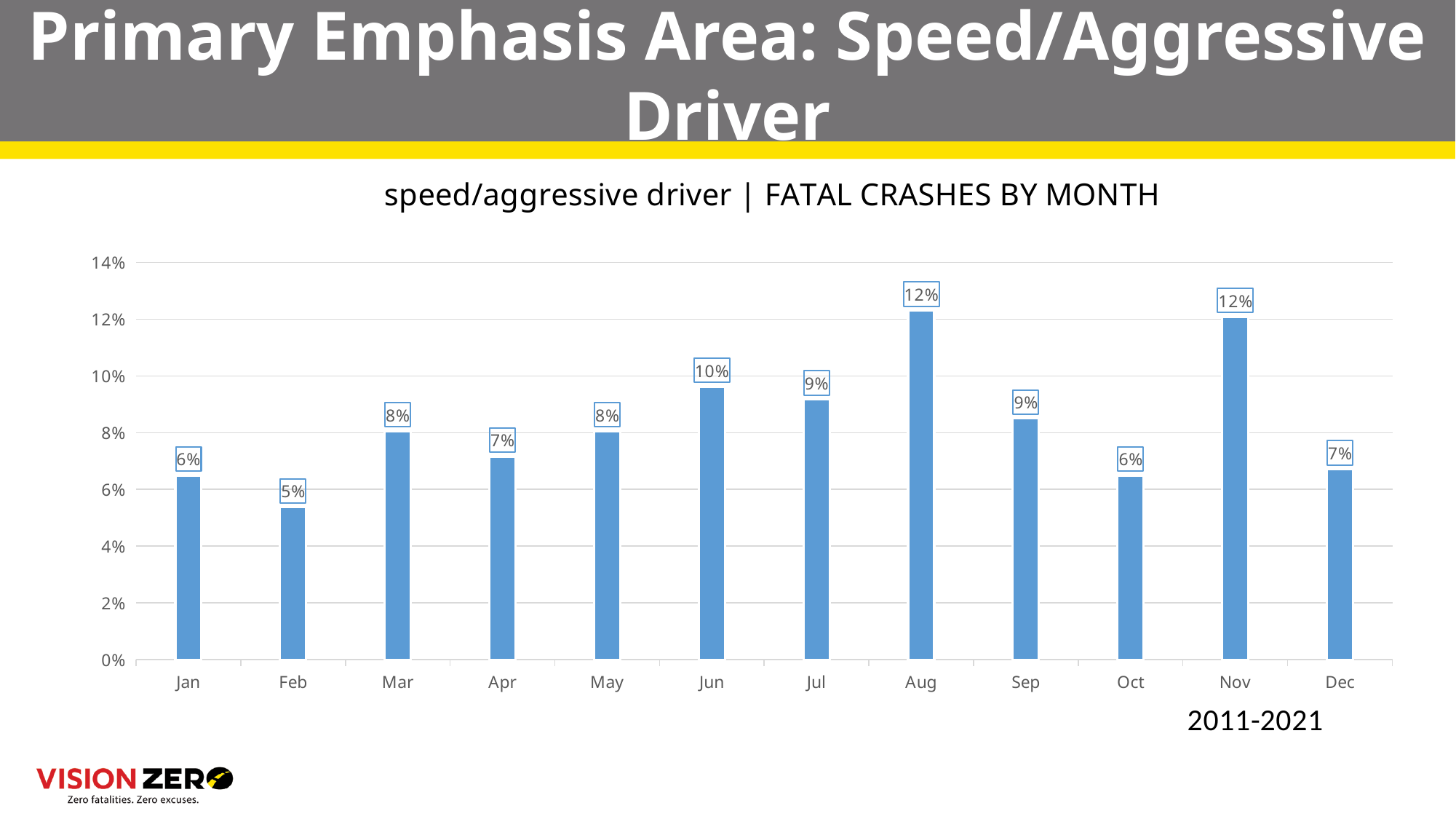
What kind of chart is shown on the slide? Bar chart What is the difference between the values for Aug and Feb? 7% What is the value for Oct in the fatal crashes by month chart? 6% Is the value for Feb greater or less than 6%? less What year range is shown below the chart? 2011-2021 How many months are shown on the x axis of the chart? 12 What is the value for Aug in the fatal crashes by month chart? 12% Do the values rise or fall from Jan to Jun? Rise What is the value for Feb in the fatal crashes by month chart? 5% Which month has the lowest share of fatal crashes in the chart? Feb Which has a larger value, Jun or Mar? Jun What is the value for Jun in the fatal crashes by month chart? 10%